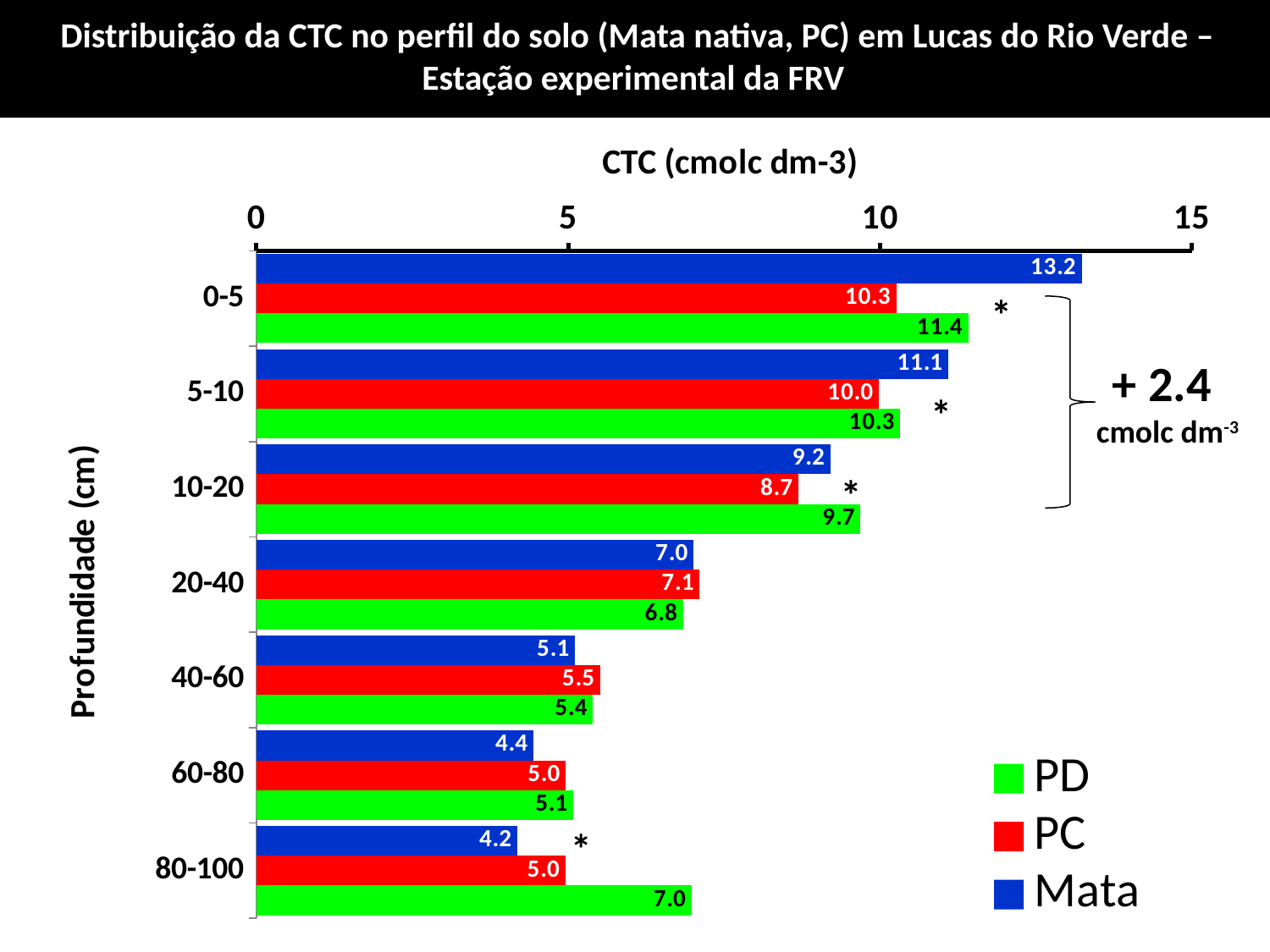
What kind of chart is shown on the slide? bar chart What is the difference between the PD and Mata values at the 80-100 cm depth? 2.8 Which colour represents the PC series in the legend? red How many depth categories are shown on the chart? 7 How many series does the legend list? 3 What is the CTC value for Mata at the 0-5 cm depth? 13.2 What is the difference between the PD and PC values at the 0-5 cm depth? 1.1 What is the CTC value for PC at the 10-20 cm depth? 8.7 Which depth has the lowest Mata CTC value? 80-100 What is the CTC value for PD at the 80-100 cm depth? 7.0 Which depth has the highest Mata CTC value? 0-5 At the 60-80 cm depth, which is larger, the PC value or the Mata value? PC